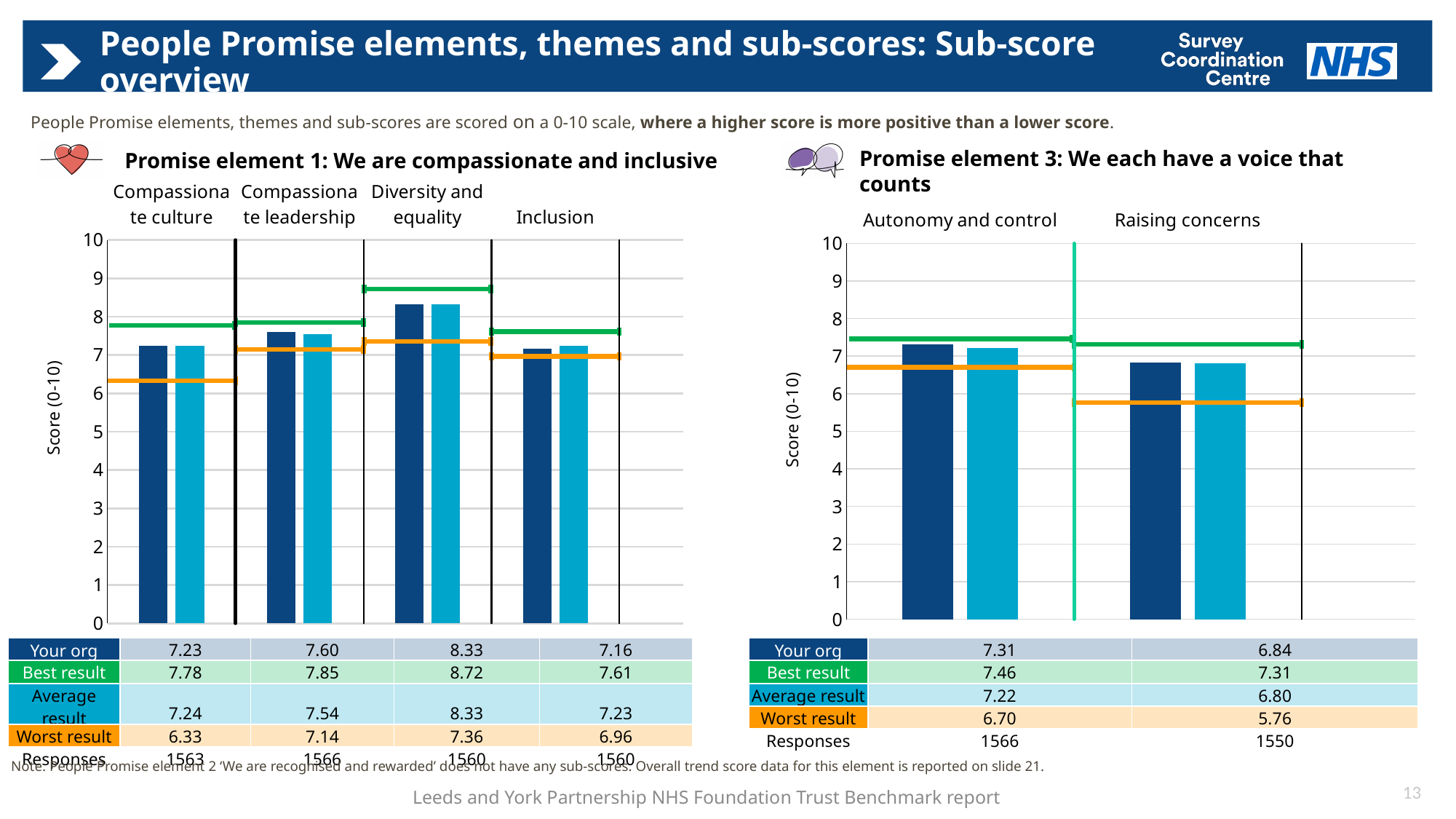
In the 'Promise element 1: We are compassionate and inclusive' chart, what is the Worst result for Compassionate culture? 6.33 In the 'Promise element 1: We are compassionate and inclusive' chart, what is the difference between the Best result and the 'Your org' score for Compassionate culture? 0.55 In the 'Promise element 3: We each have a voice that counts' chart, what is the 'Your org' score for Raising concerns? 6.84 What type of chart is used for the 'Promise element 1: We are compassionate and inclusive' data? Bar chart In the 'Promise element 1: We are compassionate and inclusive' chart, which sub-score has the lowest 'Your org' value? Inclusion In the 'Promise element 3: We each have a voice that counts' chart, what is the Best result for Autonomy and control? 7.46 In the 'Promise element 1: We are compassionate and inclusive' chart, how many sub-score categories are shown? 4 In the 'Promise element 3: We each have a voice that counts' chart, what is the difference between the Best result and the Worst result for Raising concerns? 1.55 In the 'Promise element 3: We each have a voice that counts' chart, is the 'Your org' score for Autonomy and control or for Raising concerns larger? Autonomy and control In the 'Promise element 1: We are compassionate and inclusive' chart, which sub-score has the highest 'Your org' value? Diversity and equality In the 'Promise element 3: We each have a voice that counts' chart, how many responses are recorded for Raising concerns? 1550 In the 'Promise element 1: We are compassionate and inclusive' chart, what is the 'Your org' score for Diversity and equality? 8.33